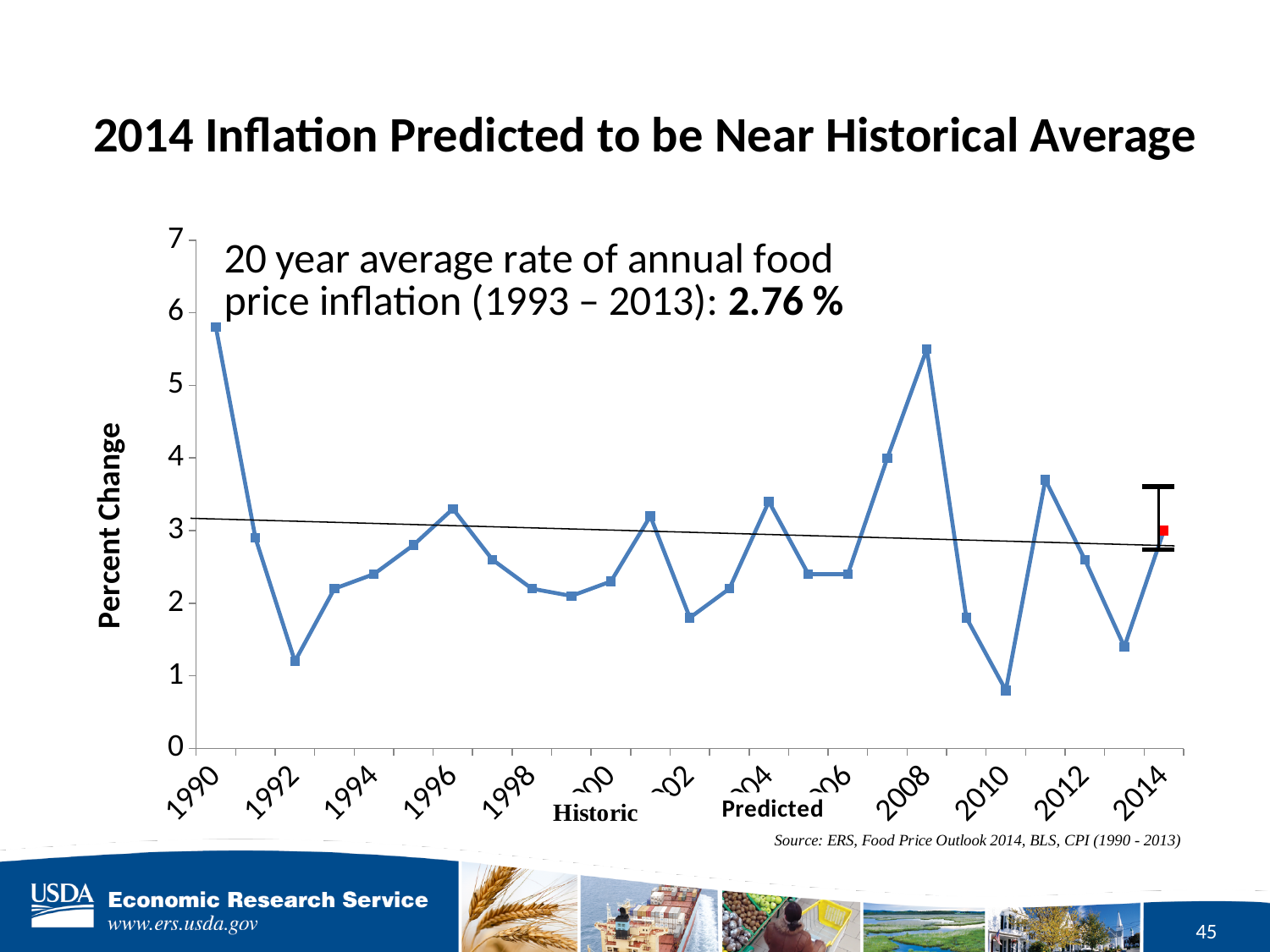
Is the value for 2008 greater or less than 5? greater Which year has the highest percent change on the chart? 1990 What 20 year average rate of annual food price inflation (1993 – 2013) is stated on the chart? 2.76 % Does the percent change rise or fall from 1990 to 1992? fall Is the value for 1990 greater or less than 5? greater Is the value for 2011 greater or less than 3? greater Which year has the lowest percent change on the chart? 2010 Which is larger, the value for 2008 or the value for 2009? 2008 What kind of chart is shown on the slide? line chart What is the label on the y axis of the chart? Percent Change